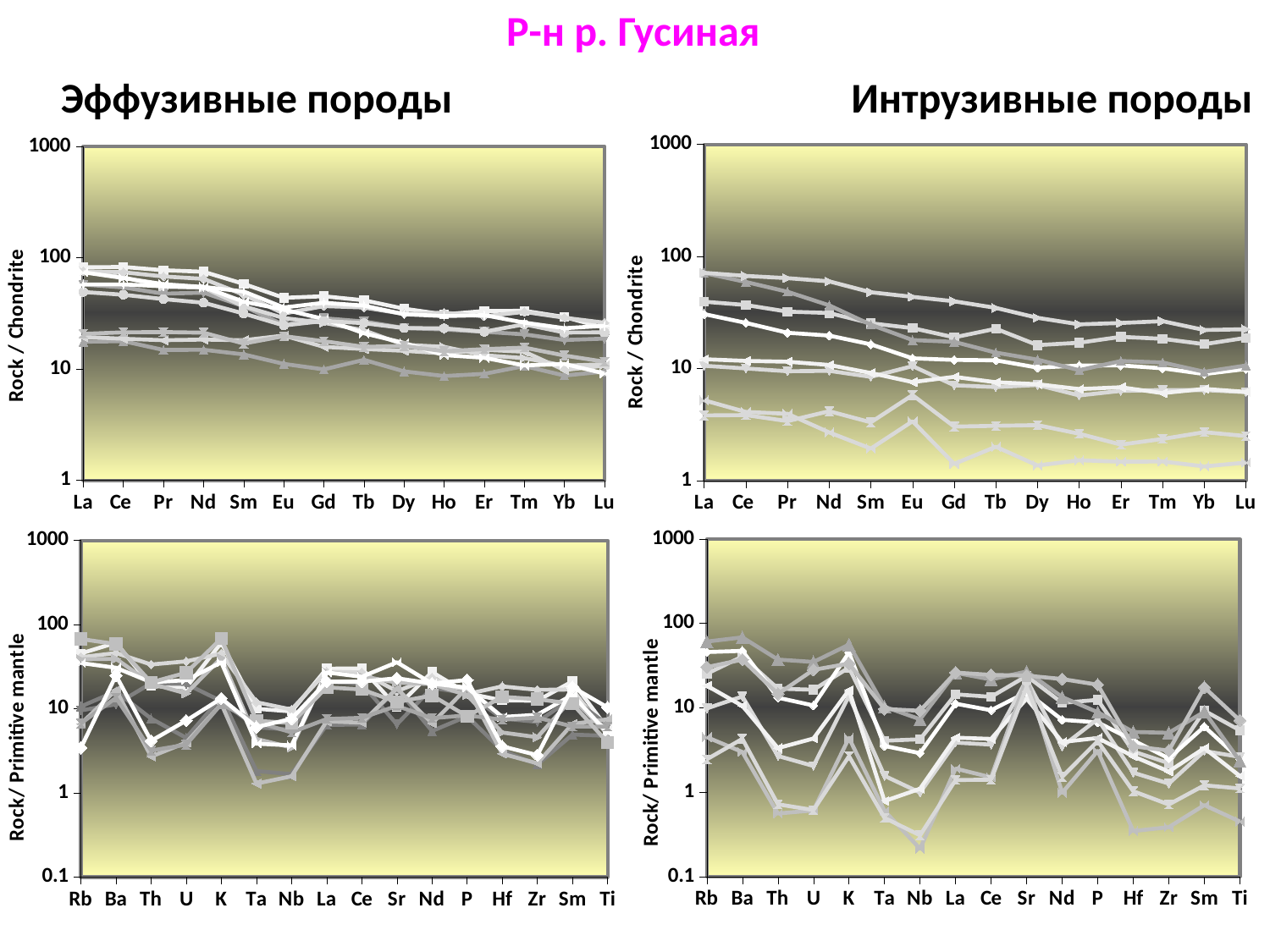
How many charts are shown on the slide? 4 In the bottom-right chart (Rock/ Primitive mantle, Интрузивные породы), is the lowest value at Nb greater or less than 1? less What is the first element on the x axis of the bottom-left chart (Rock/ Primitive mantle, Эффузивные породы)? Rb In the top-left chart (Rock / Chondrite, Эффузивные породы), is the highest value at La greater or less than 100? less In the bottom-right chart (Rock/ Primitive mantle, Интрузивные породы), how many elements are listed along the x axis? 16 In the top-right chart (Rock / Chondrite, Интрузивные породы), do the values generally rise or fall from La to Lu? fall What is the y-axis label of the top-right chart (Интрузивные породы)? Rock / Chondrite What kind of chart is the top-left chart (Эффузивные породы, Rock / Chondrite)? line chart In the top-right chart (Rock / Chondrite, Интрузивные породы), is the lowest value at Lu greater or less than 10? less In the top-left chart (Rock / Chondrite, Эффузивные породы), how many elements are listed along the x axis? 14 In the top-left chart (Rock / Chondrite, Эффузивные породы), do the values generally rise or fall from La to Lu? fall